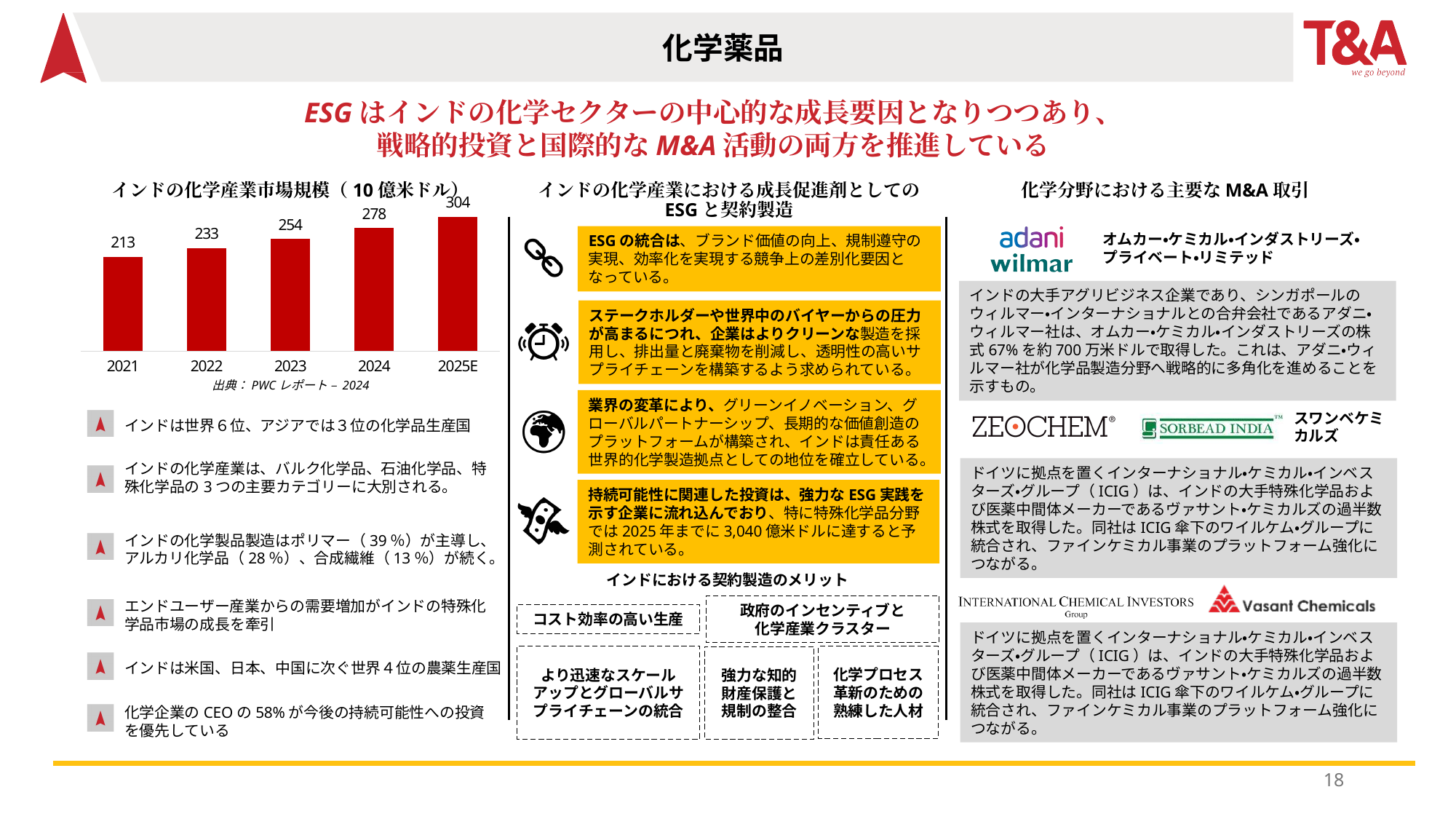
What source is cited below the chart of India's chemical industry market size? PWC レポート – 2024 Do the values in the chart of India's chemical industry market size rise or fall from 2021 to 2025E? Rise What kind of chart is used to show India's chemical industry market size? Bar chart How many bars are shown in the chart of India's chemical industry market size? 5 What is the value for 2025E in the chart of India's chemical industry market size? 304 What is the value for 2023 in the chart of India's chemical industry market size? 254 Which year has the highest value in the chart of India's chemical industry market size? 2025E What is the difference between the 2025E and 2024 values in the chart of India's chemical industry market size? 26 What is the difference between the 2024 and 2021 values in the chart of India's chemical industry market size? 65 Which is larger in the chart of India's chemical industry market size, the value for 2022 or the value for 2023? 2023 Which year has the lowest value in the chart of India's chemical industry market size? 2021 What is the value for 2021 in the chart of India's chemical industry market size? 213